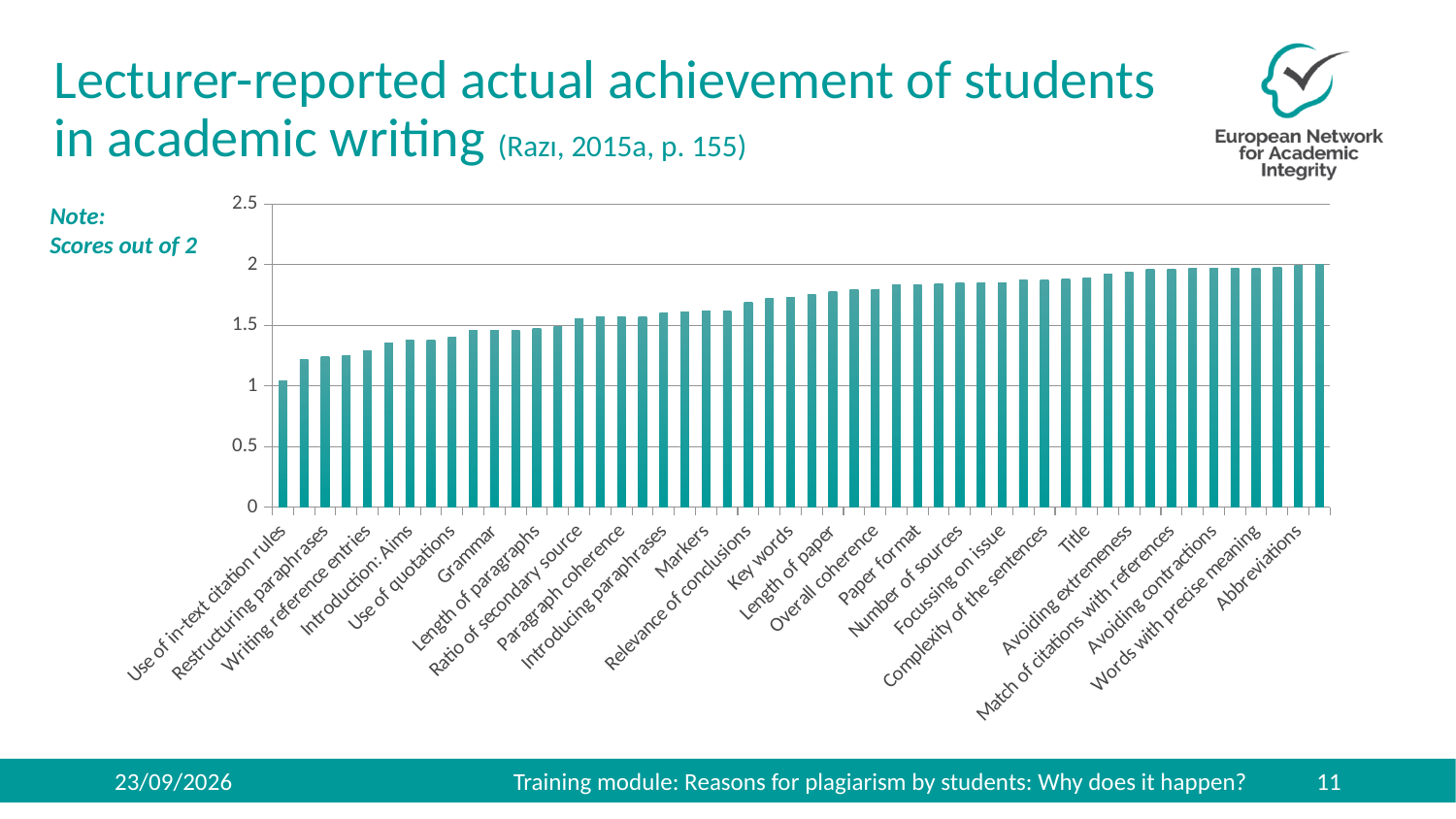
According to the note on the slide, scores are out of what maximum? 2 What kind of chart is shown on the slide? bar chart Is the value for Title greater or less than 2? less Which category has the lowest lecturer-reported achievement score? Use of in-text citation rules Which has a higher value, Use of quotations or Abbreviations? Abbreviations Is the value for Use of in-text citation rules greater or less than 1.5? less Is the value for Key words greater or less than 1.5? greater What is the highest value shown on the y axis? 2.5 Do the bar values rise or fall from left to right along the x axis? rise Which has a higher value, Grammar or Title? Title